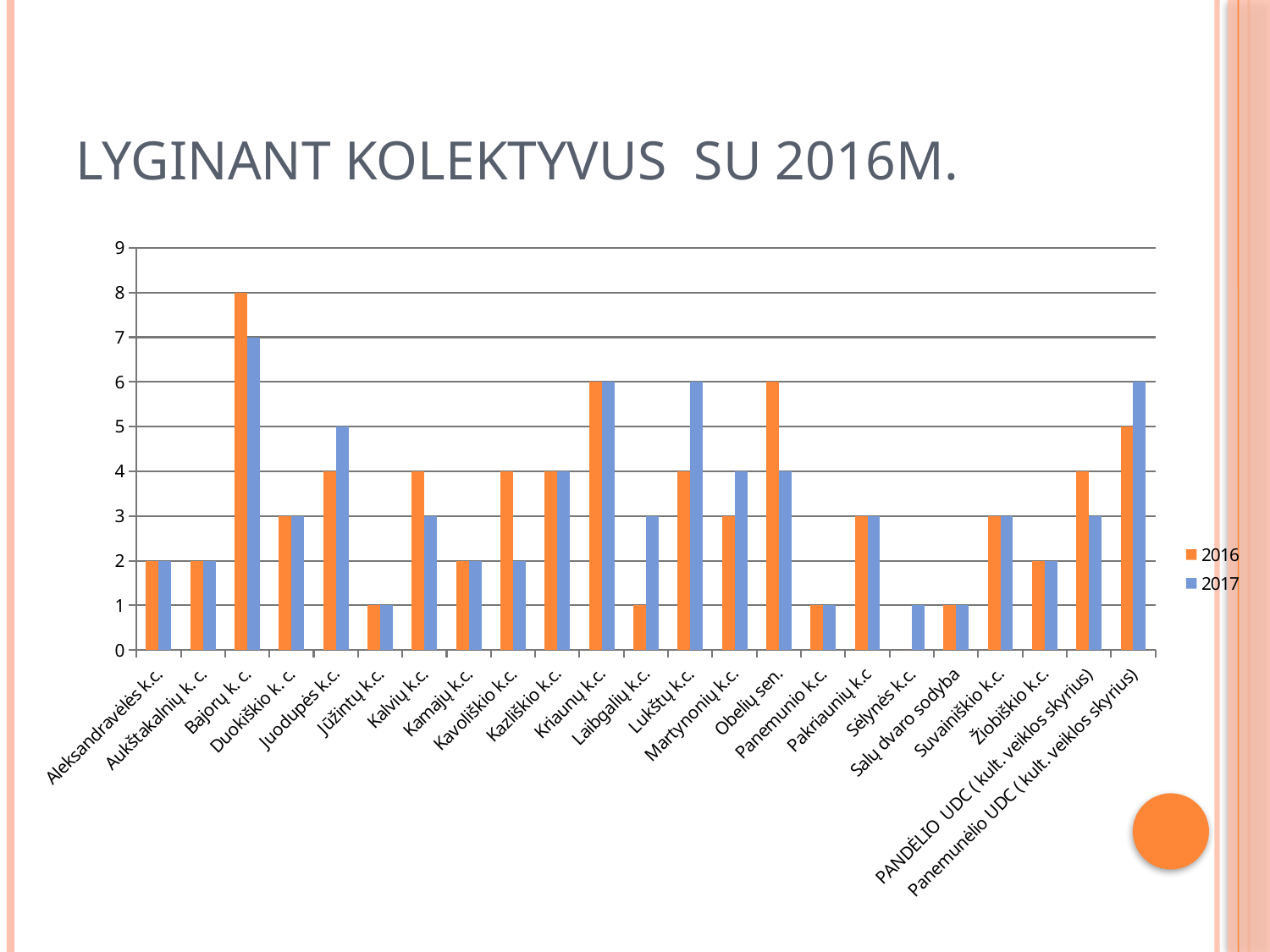
Which category has the highest value for 2017? Bajorų k. c. Is the 2017 value for Panemunėlio UDC (kult. veiklos skyrius) greater or less than 4? greater What is the 2017 value for Juodupės k.c.? 5 Which colour represents the 2017 series in the legend? blue What is the 2016 value for Obelių sen.? 6 How many series does the legend list? 2 What is the 2016 value for Bajorų k. c.? 8 How many categories are shown on the x axis? 23 For Kavoliškio k.c., which is larger, the 2016 value or the 2017 value? 2016 What type of chart is shown on the slide? bar chart Which category has the highest value for 2016? Bajorų k. c. What is the difference between the 2016 and 2017 values for Lukštų k.c.? 2